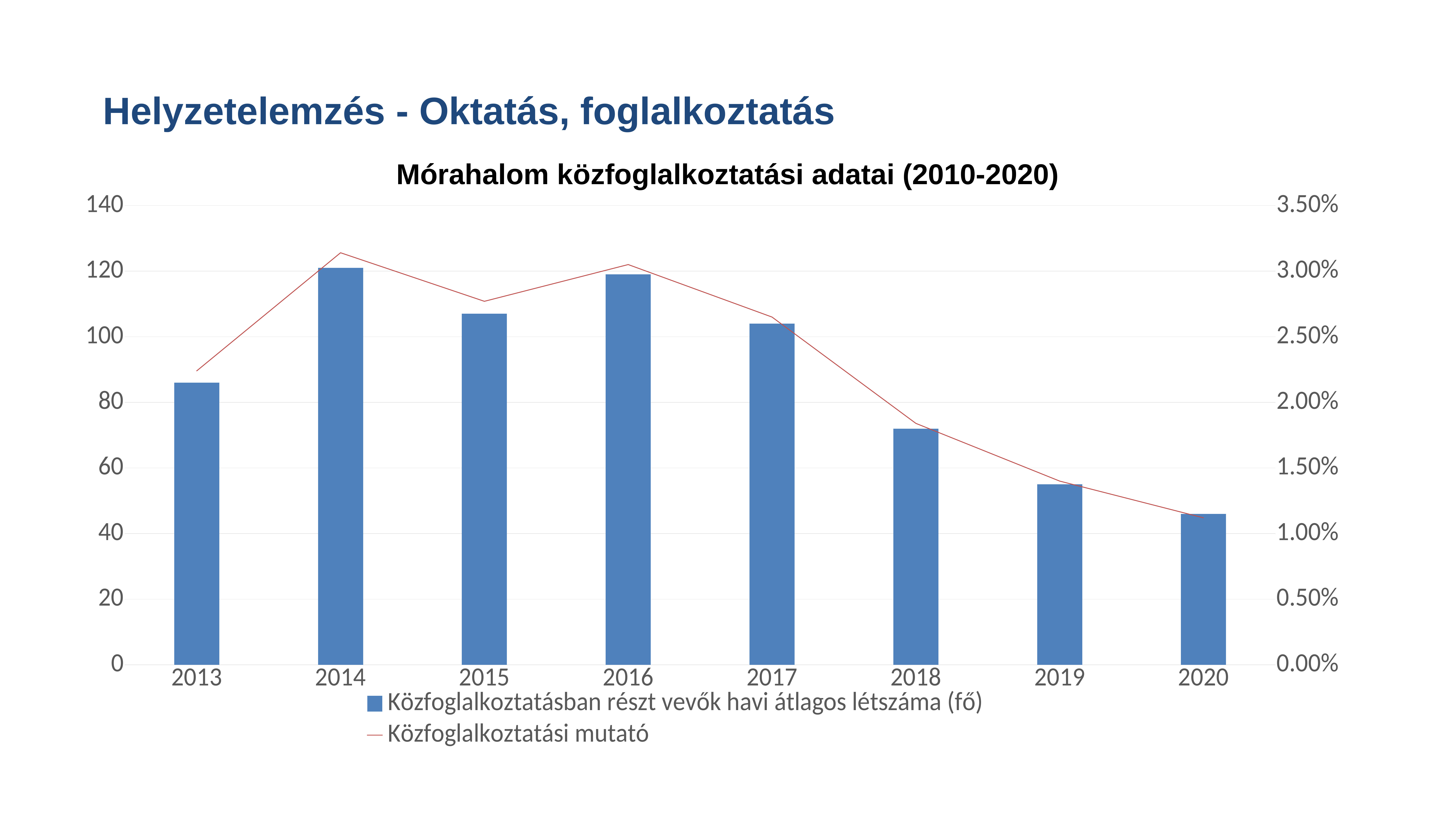
Which year has the lowest bar for Közfoglalkoztatásban részt vevők havi átlagos létszáma (fő)? 2020 How many years are shown on the x axis? 8 Which year has the lowest value on the Közfoglalkoztatási mutató line? 2020 What is the title of the chart? Mórahalom közfoglalkoztatási adatai (2010-2020) Is the Közfoglalkoztatási mutató value for 2018 greater or less than 2.00%? less Is the bar value for 2015 greater or less than 100? greater What colour is the Közfoglalkoztatási mutató line? red How many series does the legend list? 2 Is the bar value for 2013 greater or less than 80? greater Do the bar values rise or fall from 2016 to 2020? fall Which year has the larger bar, 2013 or 2017? 2017